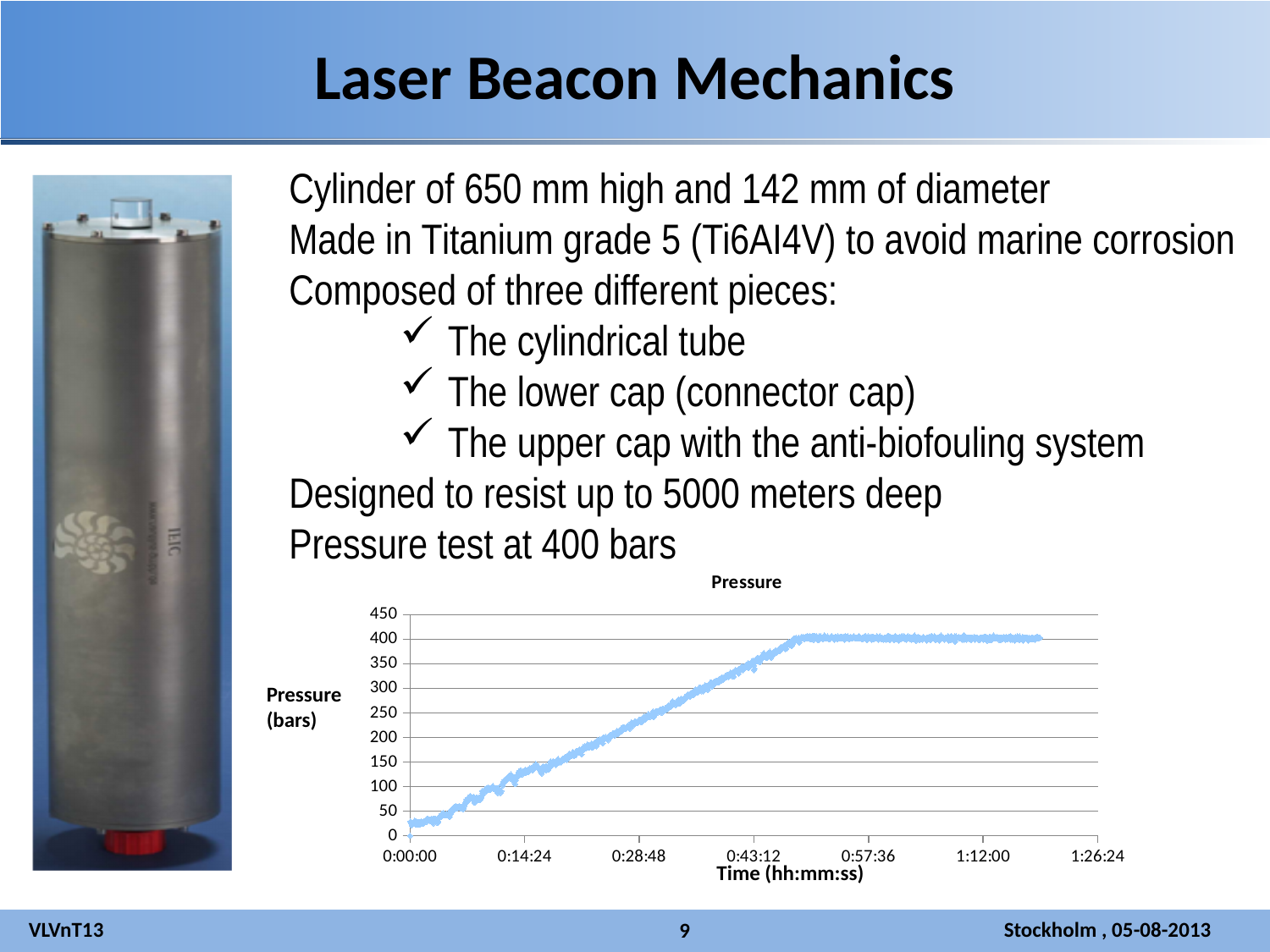
Is the pressure value at 0:43:12 greater or less than 300? greater Is the pressure value at 1:12:00 greater or less than 350? greater What kind of chart is shown on the slide? line chart Is the pressure value at 0:28:48 greater or less than 300? less Which is larger, the pressure at 0:14:24 or at 0:43:12? 0:43:12 What is the label of the x axis of the chart? Time (hh:mm:ss) How does the pressure change over time in the chart? rises, then levels off What is the title of the chart on the slide? Pressure How many time tick labels are shown on the x axis of the chart? 7